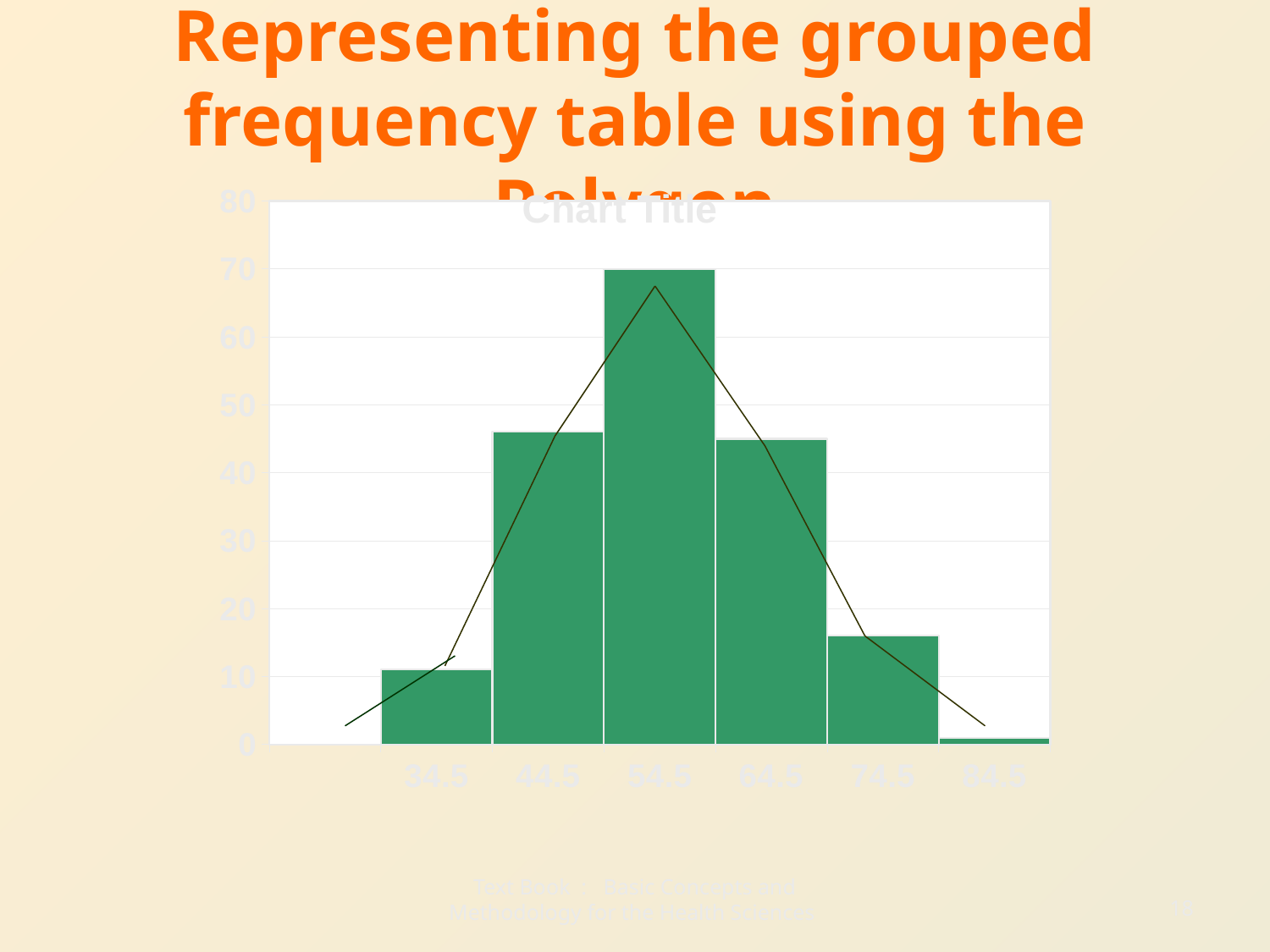
Which bar is taller, 34.5 or 74.5? 74.5 Which category has the tallest bar? 54.5 How many bars are plotted on the chart? 6 Is the value for 34.5 greater or less than 20? less What is the title printed above the chart's plot area? Chart Title Which category has the shortest bar? 84.5 What kind of chart is shown on the slide? bar chart Do the bar values rise or fall from 54.5 to 84.5 along the x axis? fall Is the value for 44.5 greater or less than 40? greater Is the value for 54.5 greater or less than 60? greater